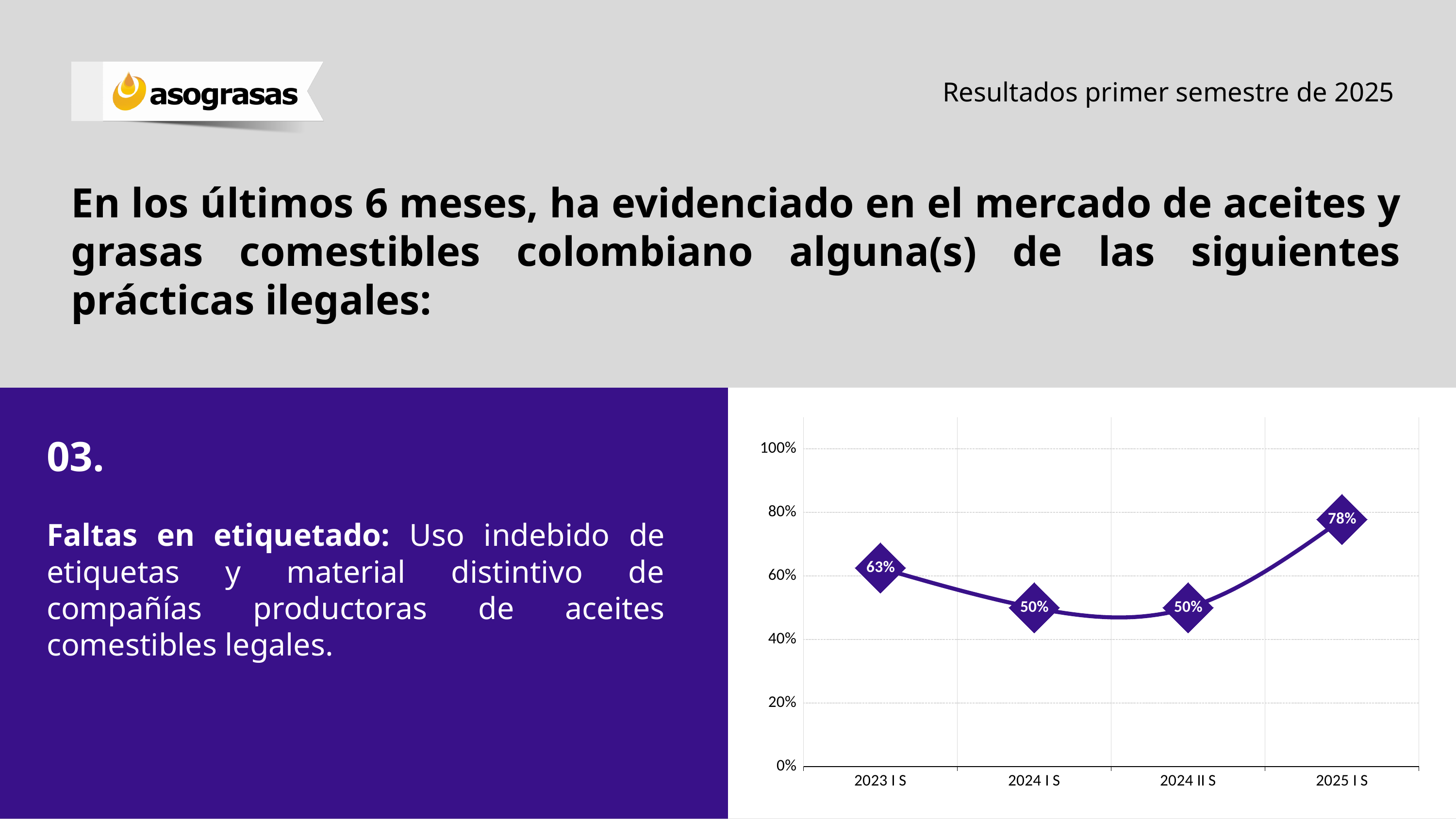
Is the value for 2025 I S greater or less than 60%? greater Which period has the highest value? 2025 I S What is the value for 2025 I S? 78% What is the difference between the values for 2025 I S and 2023 I S? 15% What kind of chart is shown on the slide? Line chart How many data points are plotted on the chart? 4 What is the value for 2024 II S? 50% What is the value for 2023 I S? 63% Which is larger, the value for 2025 I S or the value for 2024 II S? 2025 I S What is the value for 2024 I S? 50% What is the difference between the values for 2023 I S and 2024 I S? 13% Does the value rise or fall from 2024 II S to 2025 I S? Rise